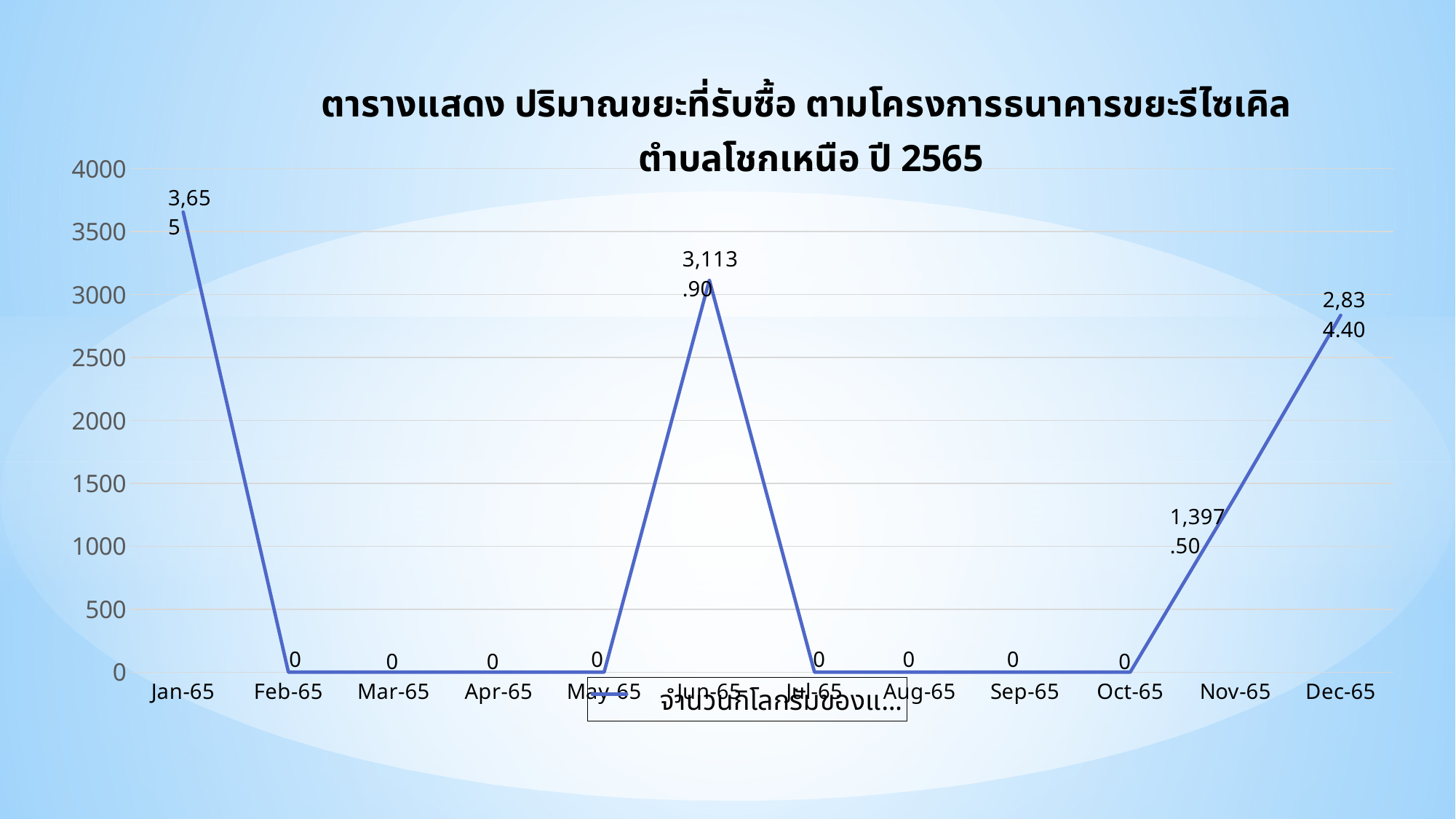
What is the value for Dec-65? 2,834.40 How many months have a value of 0? 8 What is the value for Jan-65? 3,655 Is the value for Jan-65 greater or less than 3500? greater What is the difference between the values for Dec-65 and Nov-65? 1,436.90 What is the value for Jun-65? 3,113.90 What is the value for Nov-65? 1,397.50 Which month has the highest value? Jan-65 What is the value for Feb-65? 0 What kind of chart is shown on the slide? line chart How many months are plotted along the x axis? 12 Which is larger, the value for Jun-65 or the value for Dec-65? Jun-65